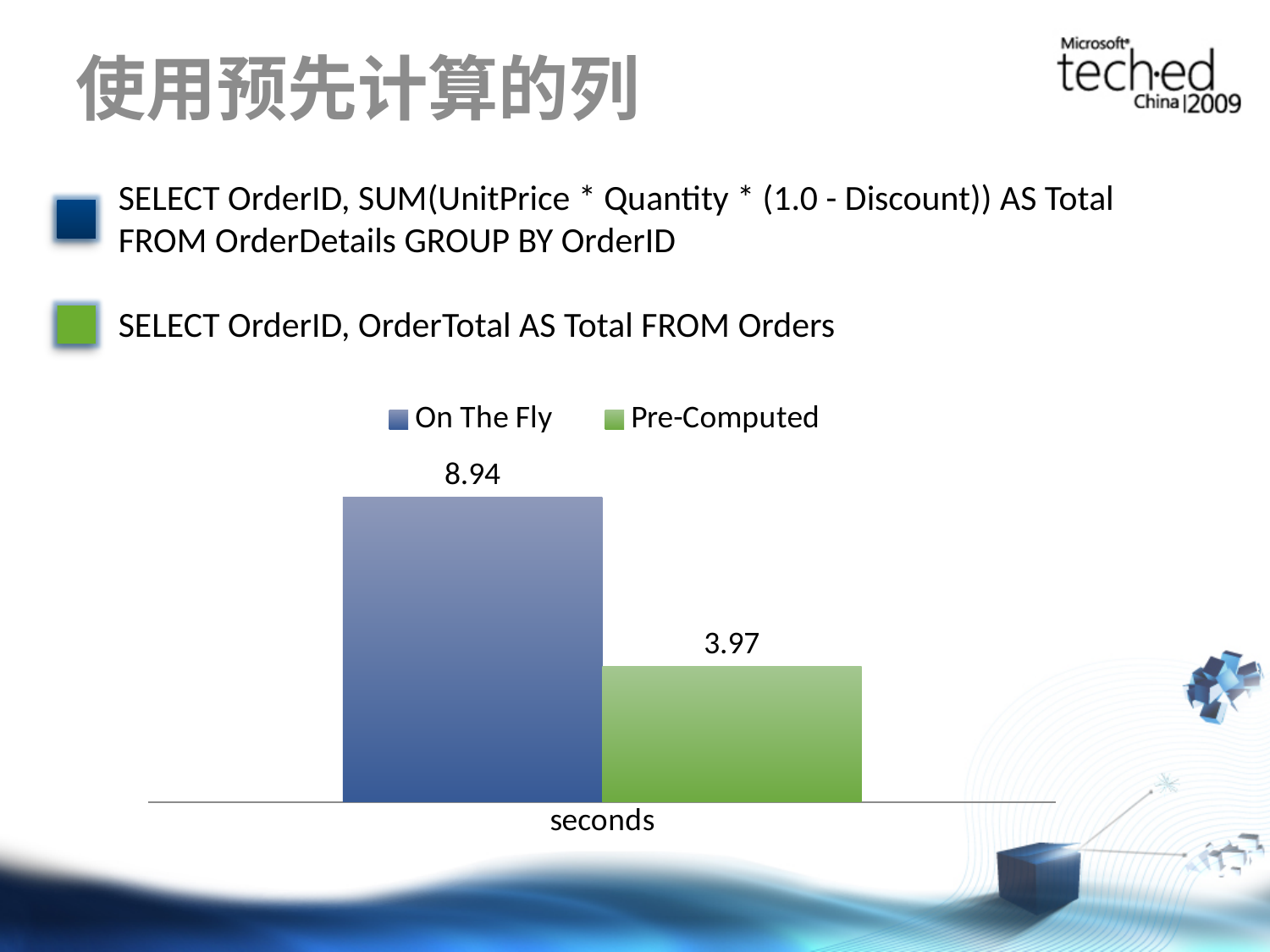
What is the value for Pre-Computed? 3.97 Which is larger, the On The Fly value or the Pre-Computed value? On The Fly What is the difference between the On The Fly and Pre-Computed values? 4.97 What kind of chart is shown on the slide? bar chart Which series has the highest value? On The Fly Which series has the lowest value? Pre-Computed How many series does the legend list? 2 What is the label on the x axis of the chart? seconds How many bars are plotted in the chart? 2 What is the value for On The Fly? 8.94 What colour is the Pre-Computed bar? green